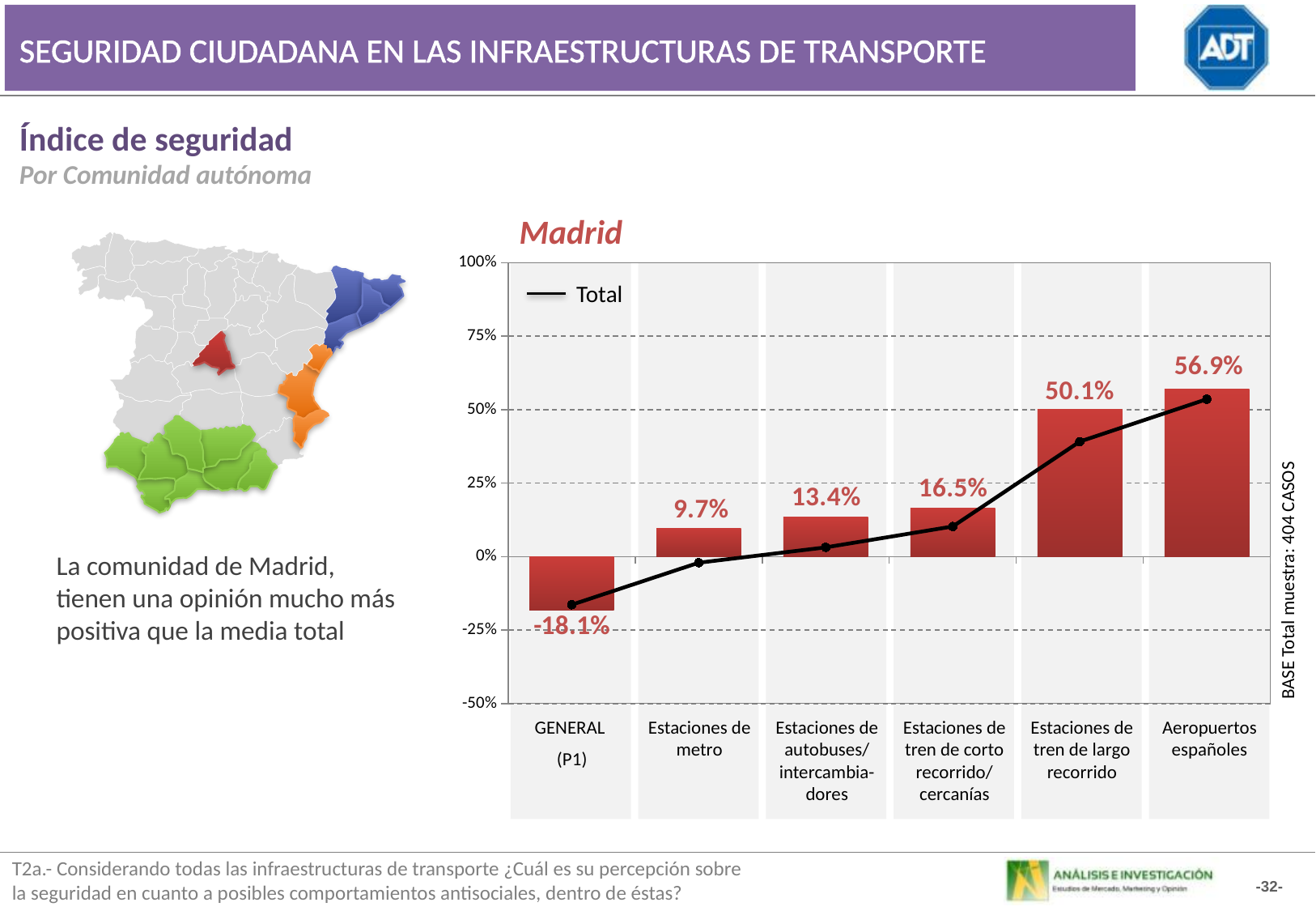
What is the difference between the Madrid bar values for Aeropuertos españoles and Estaciones de tren de largo recorrido? 6.8% How many series does the chart legend list? 1 Do the Madrid bar values rise or fall from left to right across the categories? rise Is the Total line value for GENERAL (P1) greater or less than 0%? less Which category has the highest Madrid bar value? Aeropuertos españoles Which category has the lowest Madrid bar value? GENERAL (P1) What is the value of the Madrid bar for GENERAL (P1)? -18.1% Is the Total line value for Estaciones de tren de largo recorrido greater or less than 50%? less What is the value of the Madrid bar for Aeropuertos españoles? 56.9% Which has a larger Madrid bar value: Estaciones de metro or Estaciones de autobuses/intercambiadores? Estaciones de autobuses/intercambiadores What is the value of the Madrid bar for Estaciones de tren de corto recorrido/cercanías? 16.5% How many categories are shown on the x axis of the chart? 6